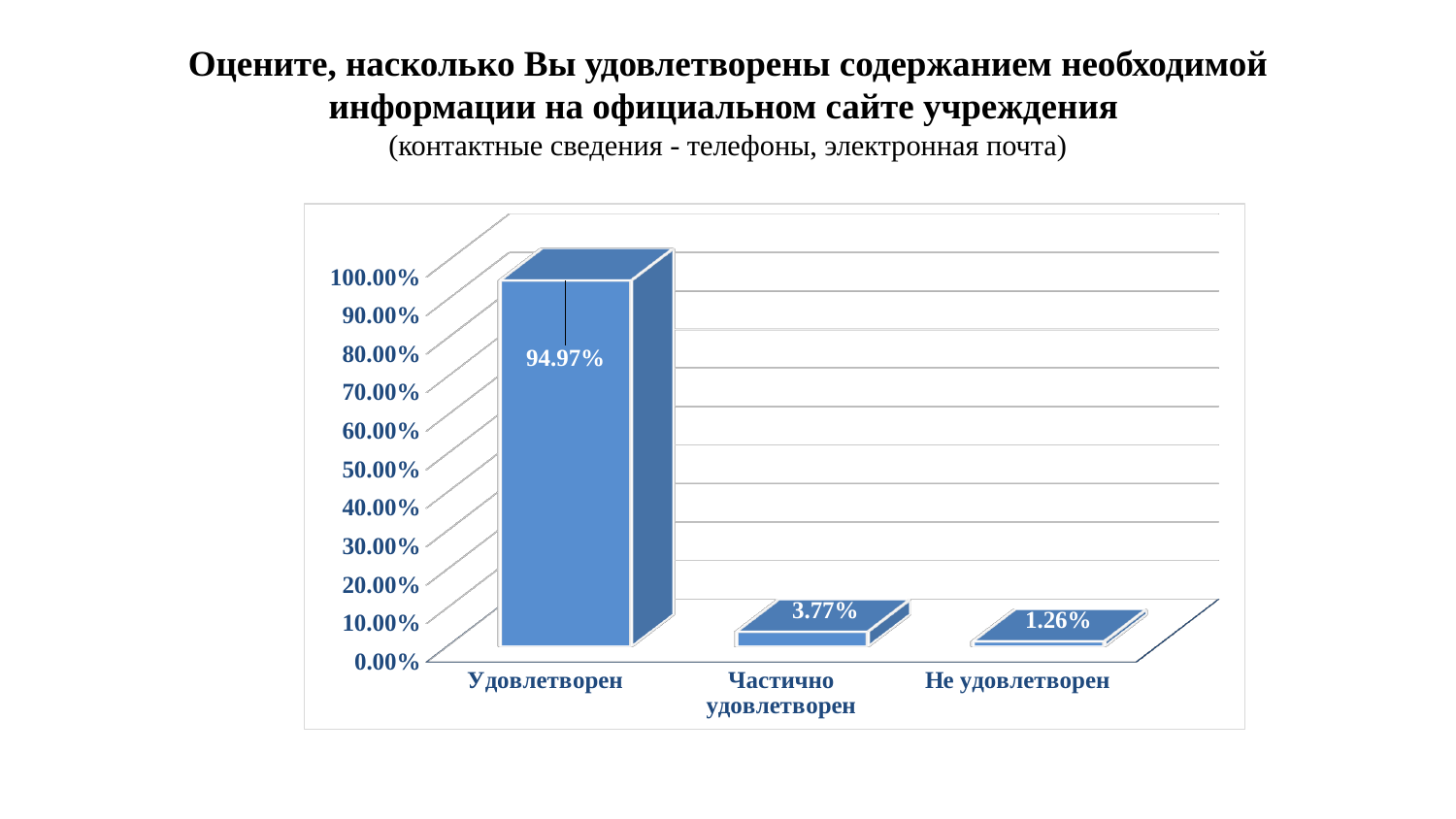
What is the value for Не удовлетворен? 1.26% How many categories are shown on the x axis? 3 What is the difference between the values for Удовлетворен and Частично удовлетворен? 91.20% Which category has the highest value? Удовлетворен What is the difference between the values for Частично удовлетворен and Не удовлетворен? 2.51% Which category has the lowest value? Не удовлетворен What is the value for Частично удовлетворен? 3.77% Which is larger, the value for Частично удовлетворен or the value for Не удовлетворен? Частично удовлетворен Do the values rise or fall from left to right along the x axis? fall What is the value for Удовлетворен? 94.97% What kind of chart is shown on the slide? bar chart Is the value for Удовлетворен greater or less than 90.00%? greater